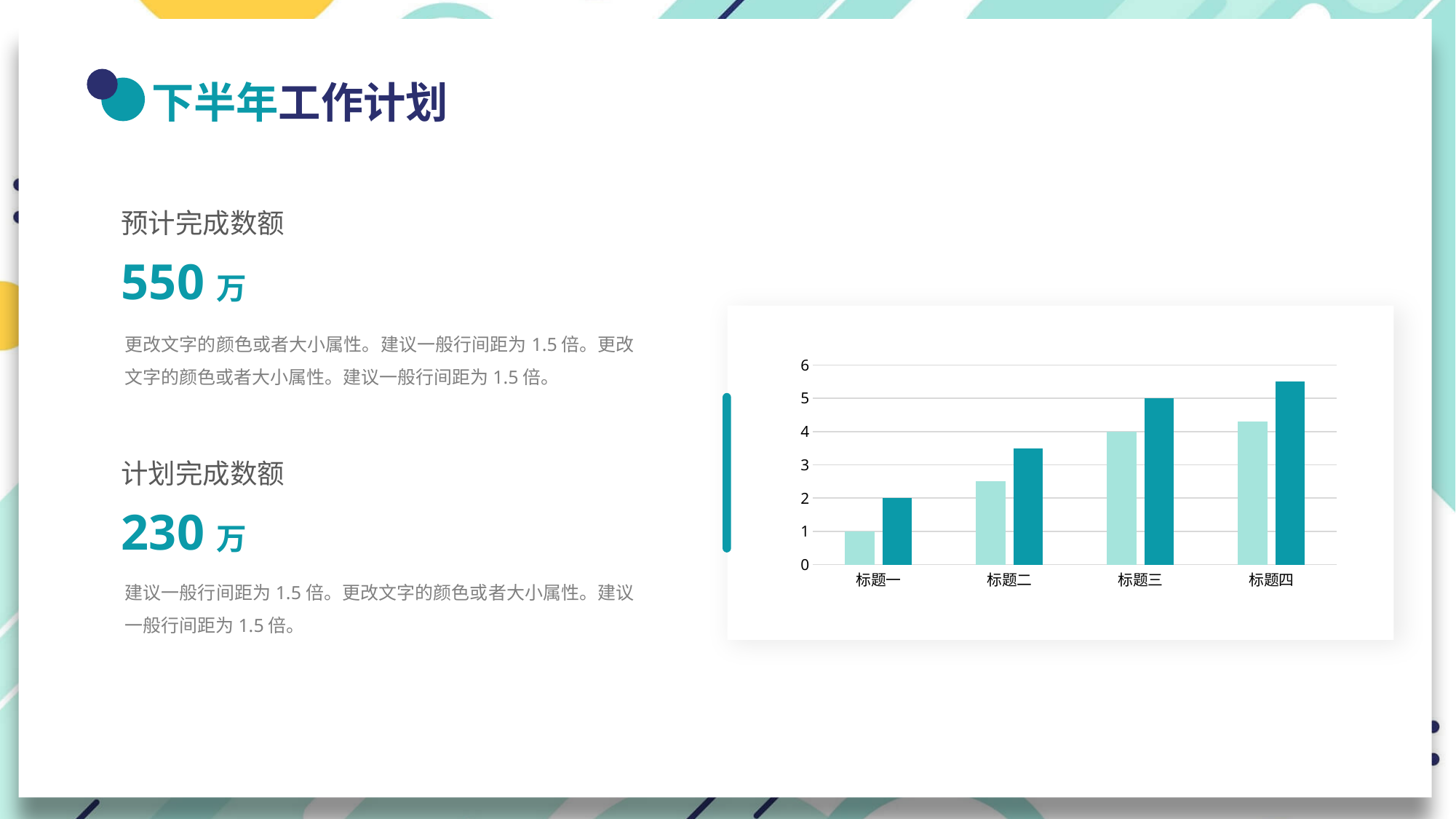
What is the highest value shown on the chart's vertical axis? 6 How many bars are plotted for each category in the chart? 2 Is the dark-coloured bar for 标题二 greater or less than 3? greater Do the dark-coloured bars rise or fall from 标题一 to 标题四? rise What is the difference between the dark-coloured bar for 标题三 and the light-coloured bar for 标题一? 4 What is the value of the dark-coloured bar for 标题三? 5 Which category has the tallest dark-coloured bar? 标题四 What is the value of the dark-coloured bar for 标题一? 2 What kind of chart is shown on the slide? bar chart What is the value of the light-coloured bar for 标题一? 1 Which category has the shortest light-coloured bar? 标题一 How many categories are shown on the x axis of the chart? 4